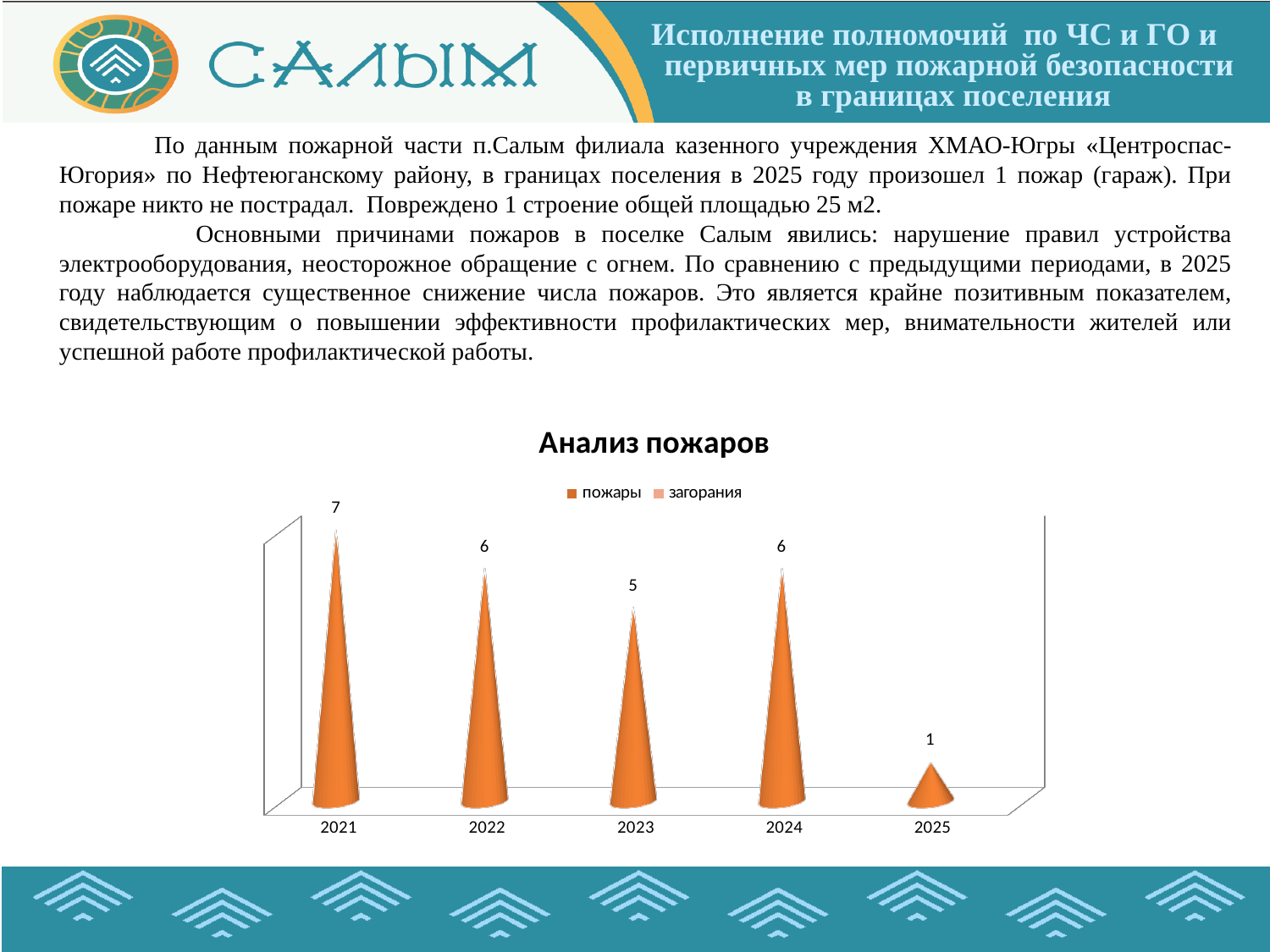
What is the title of the chart on the slide? Анализ пожаров What is the value for 2023 in the 'Анализ пожаров' chart? 5 Which is larger in the 'Анализ пожаров' chart, the value for 2023 or the value for 2024? 2024 What is the value for 2024 in the 'Анализ пожаров' chart? 6 What is the difference between the values for 2022 and 2023 in the 'Анализ пожаров' chart? 1 Which year has the lowest value in the 'Анализ пожаров' chart? 2025 Which year has the highest value in the 'Анализ пожаров' chart? 2021 What is the value for 2021 in the 'Анализ пожаров' chart? 7 How many series does the legend of the 'Анализ пожаров' chart list? 2 What is the difference between the values for 2021 and 2025 in the 'Анализ пожаров' chart? 6 What is the value for 2025 in the 'Анализ пожаров' chart? 1 How many years are shown on the x axis of the 'Анализ пожаров' chart? 5